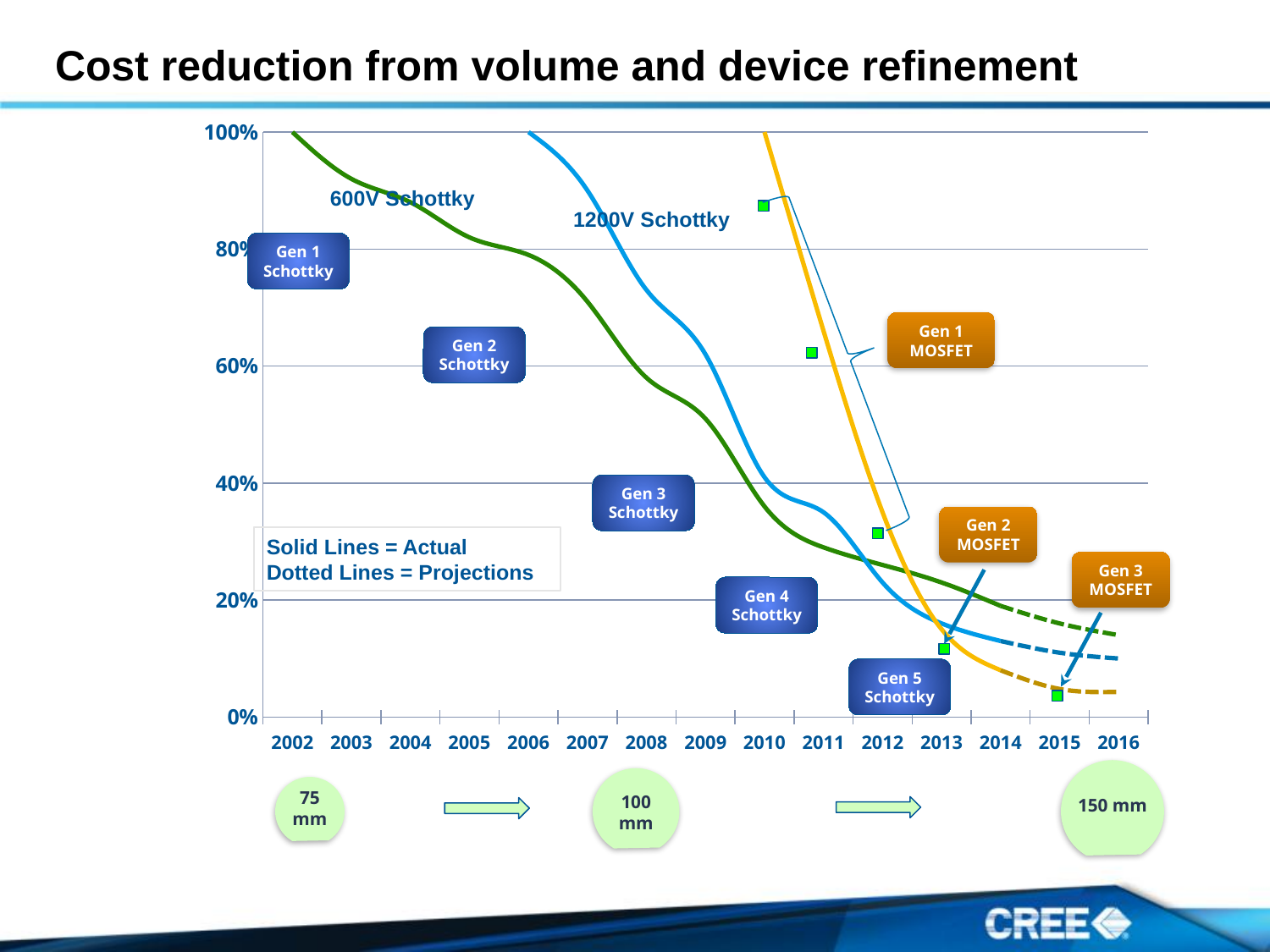
Do the values of the 600V Schottky line rise or fall from 2002 to 2016? fall In 2008, which line is higher: 600V Schottky or 1200V Schottky? 1200V Schottky What is the title of the slide? Cost reduction from volume and device refinement What kind of chart is shown on the slide? line chart Is the value of the 600V Schottky line in 2010 greater or less than 40%? less Do the values of the 1200V Schottky line rise or fall over time? fall Is the value of the 600V Schottky line in 2007 greater or less than 60%? greater According to the chart's note, what do dotted lines represent? Projections Is the value of the 600V Schottky line in 2004 greater or less than 80%? greater How many years are labelled on the x axis of the chart? 15 Which line has the lowest projected value in 2016? the yellow MOSFET line